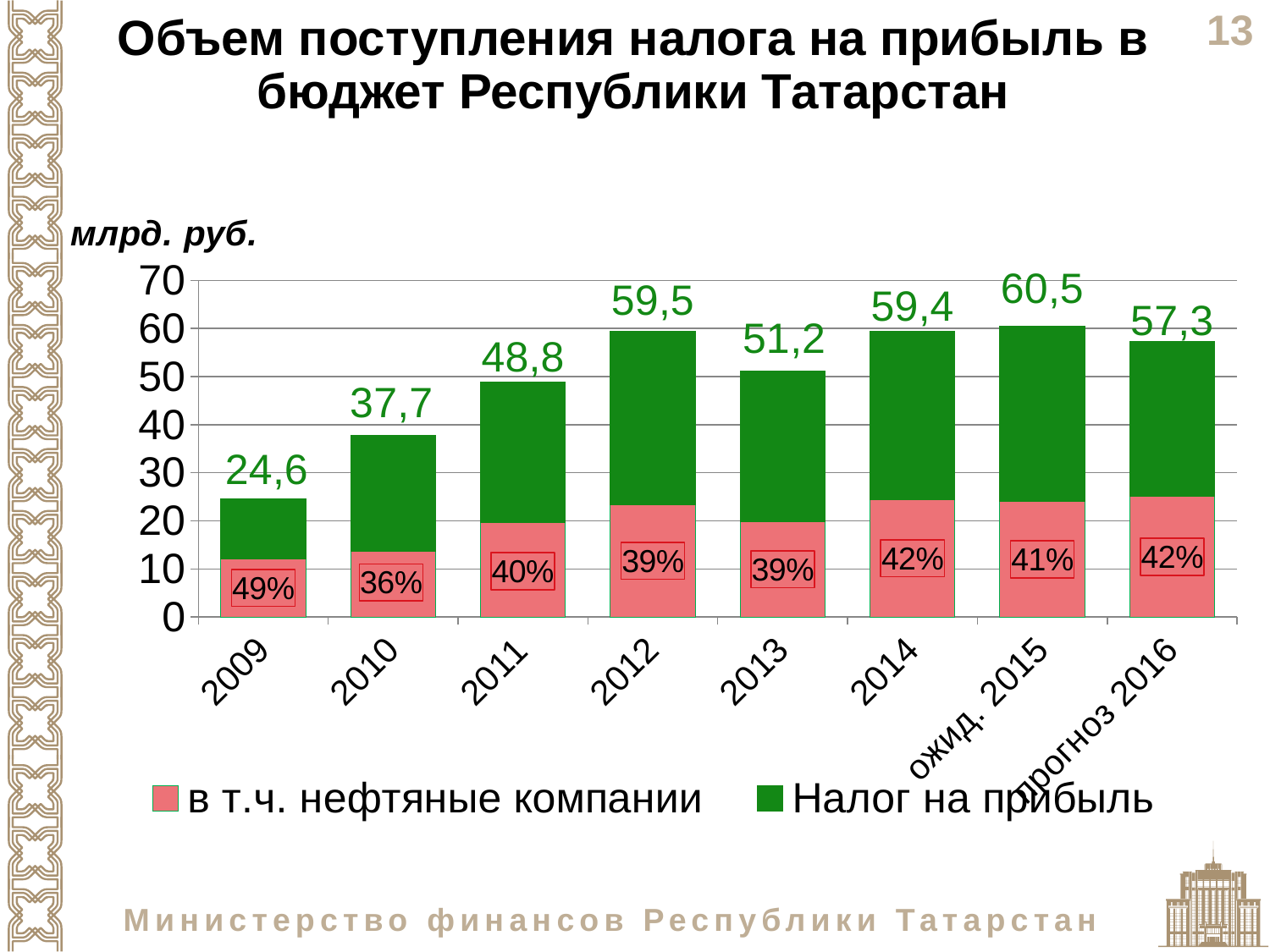
What is the value of Налог на прибыль for 2009? 24,6 Which category has the lowest value of Налог на прибыль? 2009 How many series does the legend list? 2 What percentage label is shown for нефтяные компании in 2014? 42% Is the value for нефтяные компании in 2012 greater or less than 20? greater What is the difference between the Налог на прибыль values for ожид. 2015 and 2009? 35,9 What is the value of Налог на прибыль for 2012? 59,5 Which is larger, the Налог на прибыль value for 2013 or for 2014? 2014 Which category has the highest value of Налог на прибыль? ожид. 2015 Does the value of Налог на прибыль rise or fall from 2009 to 2012? rise What percentage label is shown for нефтяные компании in 2010? 36% How many categories are shown on the x axis? 8